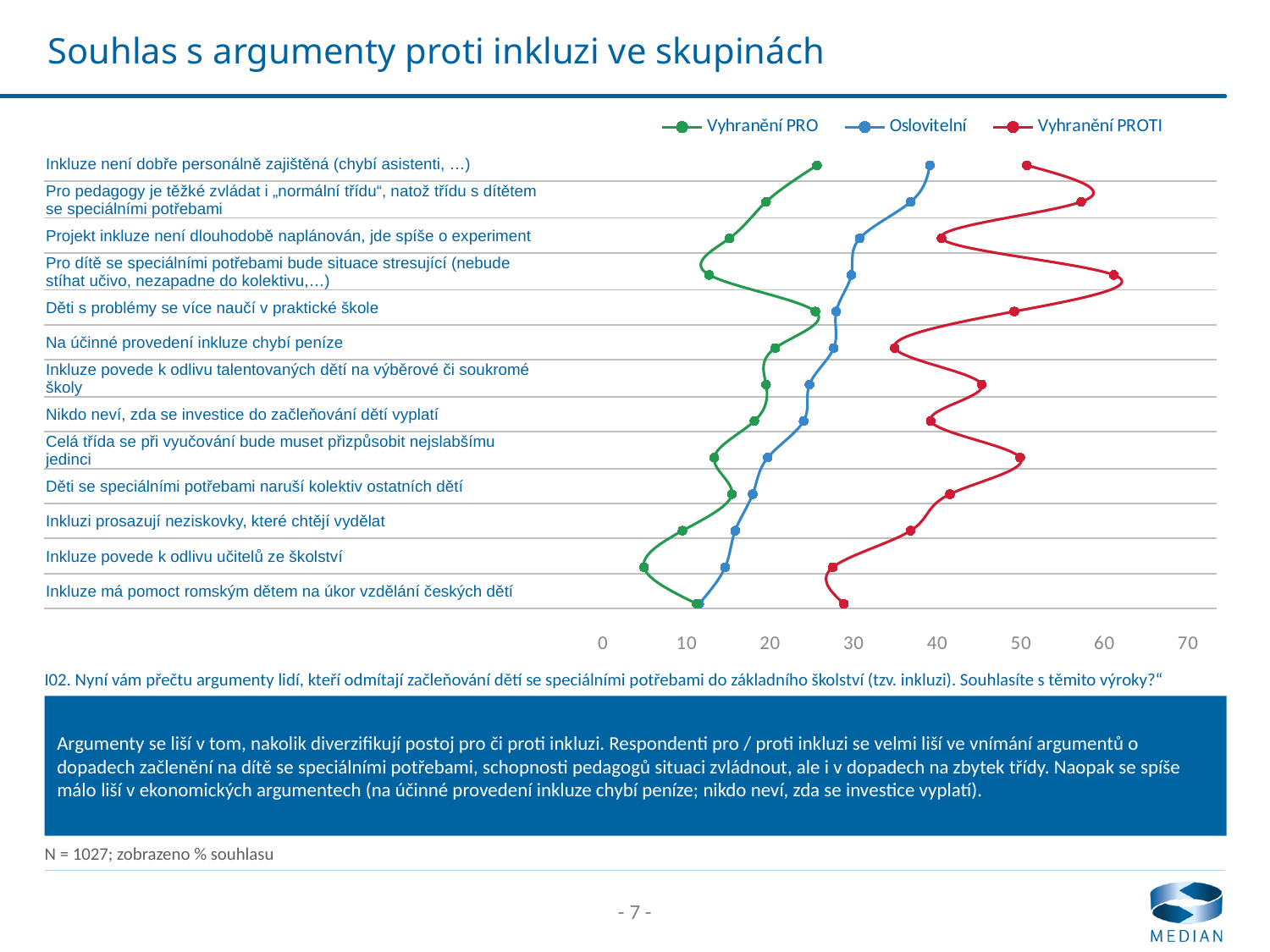
Is the value for Vyhranění PRO on 'Inkluze povede k odlivu učitelů ze školství' greater or less than 10? less What kind of chart is shown on the slide? Line chart Which colour is used for the Oslovitelní series? Blue For 'Pro pedagogy je těžké zvládat i „normální třídu“', which series has the larger value: Vyhranění PRO or Vyhranění PROTI? Vyhranění PROTI How many argument statements (categories) are plotted on the chart? 13 For which statement is the value for Oslovitelní the highest? Inkluze není dobře personálně zajištěná (chybí asistenti, …) How many series does the legend list? 3 Is the value for Vyhranění PROTI on 'Na účinné provedení inkluze chybí peníze' greater or less than 40? less Is the value for Vyhranění PROTI on 'Pro dítě se speciálními potřebami bude situace stresující' greater or less than 50? greater For which statement is the value for Vyhranění PRO the lowest? Inkluze povede k odlivu učitelů ze školství For which statement is the value for Vyhranění PROTI the highest? Pro dítě se speciálními potřebami bude situace stresující (nebude stíhat učivo, nezapadne do kolektivu,…)